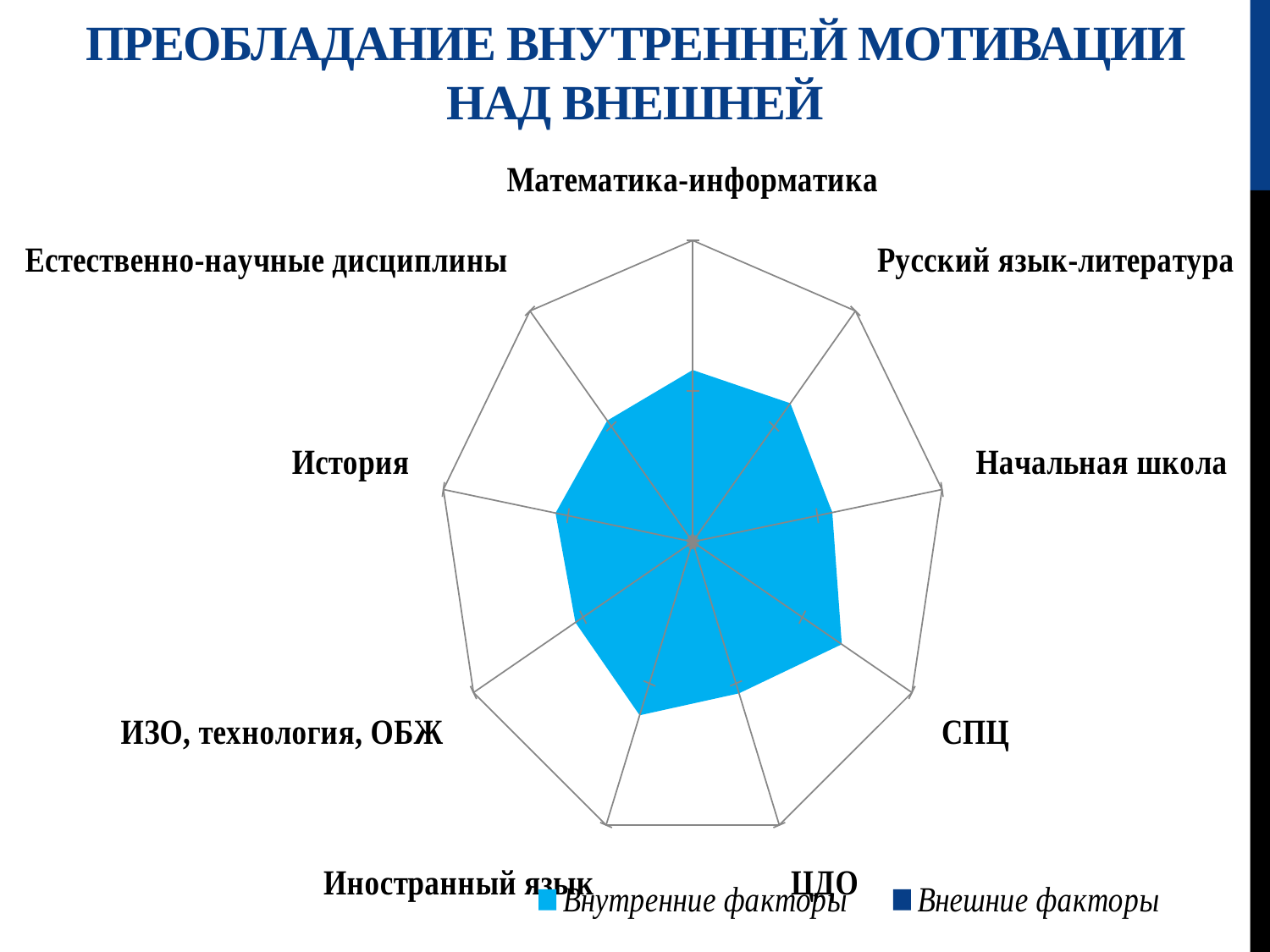
Which series is shown in light blue in the chart legend? Внутренние факторы How many series does the legend of the chart list? 2 How many categories (axes) does the radar chart have? 9 What kind of chart is shown on the slide? Radar chart What is the title of the slide containing the chart? ПРЕОБЛАДАНИЕ ВНУТРЕННЕЙ МОТИВАЦИИ НАД ВНЕШНЕЙ Which category label appears at the top of the radar chart? Математика-информатика